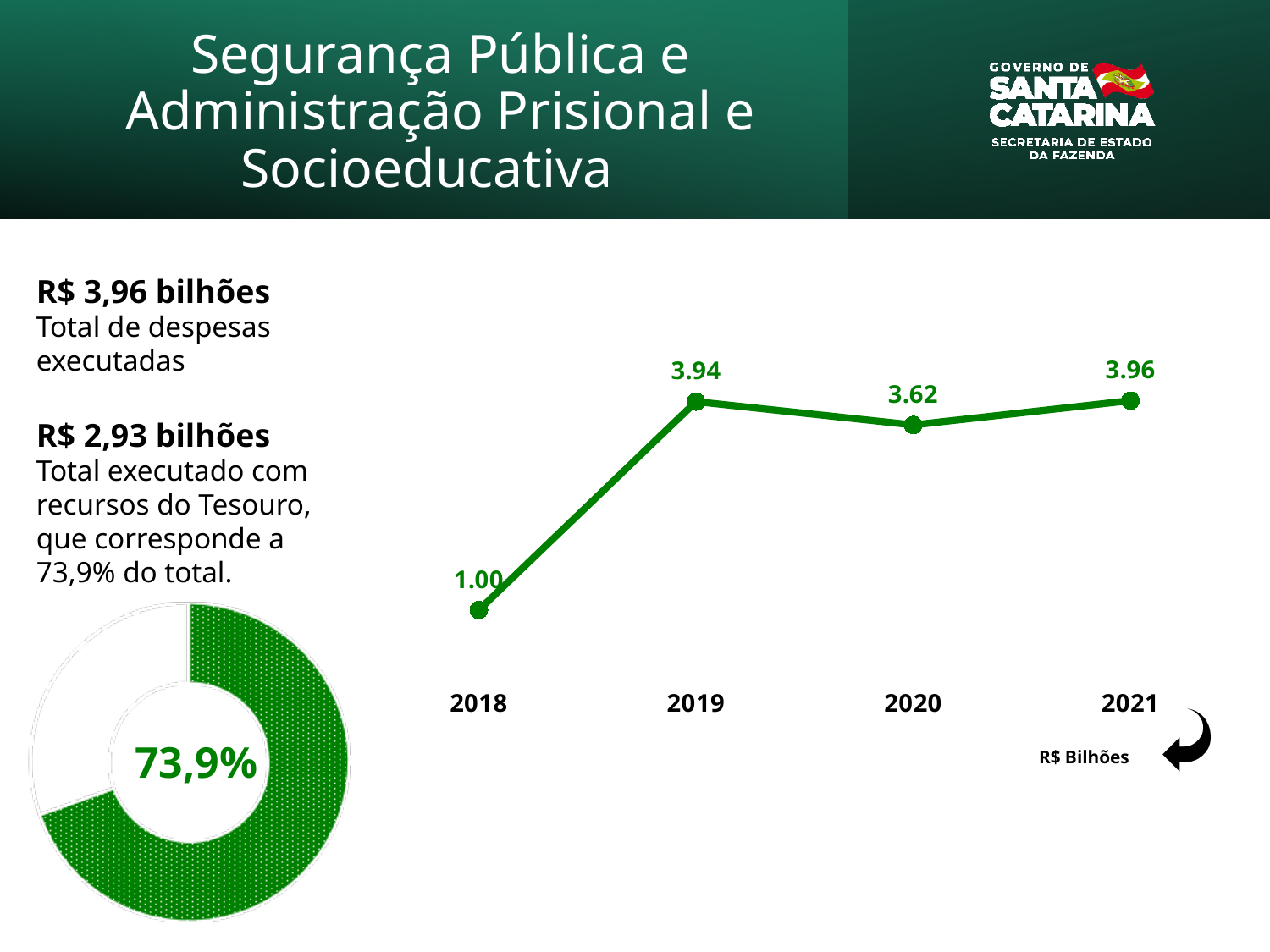
In the line chart, what is the value for 2018? 1.00 In the line chart, what is the difference between the values for 2021 and 2020? 0.34 How many years are plotted in the line chart? 4 What kind of chart is the chart on the right side of the slide? Line chart What unit label is shown below the line chart? R$ Bilhões In the line chart, which year has the larger value, 2019 or 2020? 2019 In the line chart, which year has the lowest value? 2018 In the line chart, what is the difference between the values for 2019 and 2018? 2.94 In the donut chart on the left, what share does the green slice represent? 73,9% In the line chart, does the value rise or fall from 2019 to 2020? Fall In the line chart, what is the value for 2019? 3.94 In the line chart, which year has the highest value? 2021